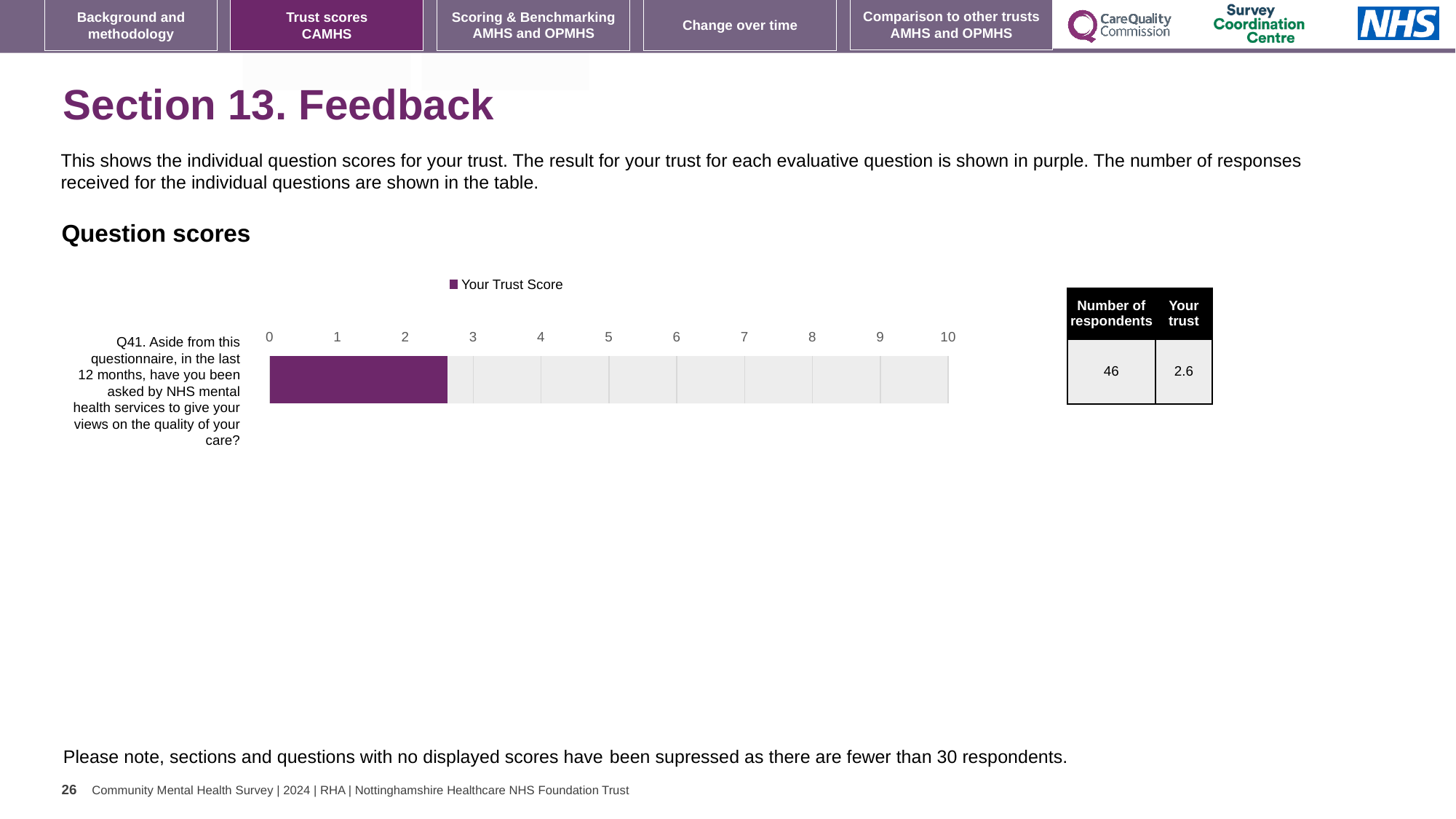
How many series does the legend of the Question scores chart list? 1 Is the bar for Q41 in the Question scores chart greater or less than 2? greater What is the name of the series shown in the legend of the Question scores chart? Your Trust Score How many respondents answered Q41 according to the table next to the chart? 46 Is the bar for Q41 in the Question scores chart greater or less than 5? less Which question number is plotted in the Question scores chart? Q41 What kind of chart is shown under the heading "Question scores"? bar chart What is the maximum value shown on the horizontal axis of the Question scores chart? 10 What is the trust score for Q41 shown in the table next to the chart? 2.6 Is the bar for Q41 in the Question scores chart greater or less than 3? less How many questions (categories) are plotted in the Question scores chart? 1